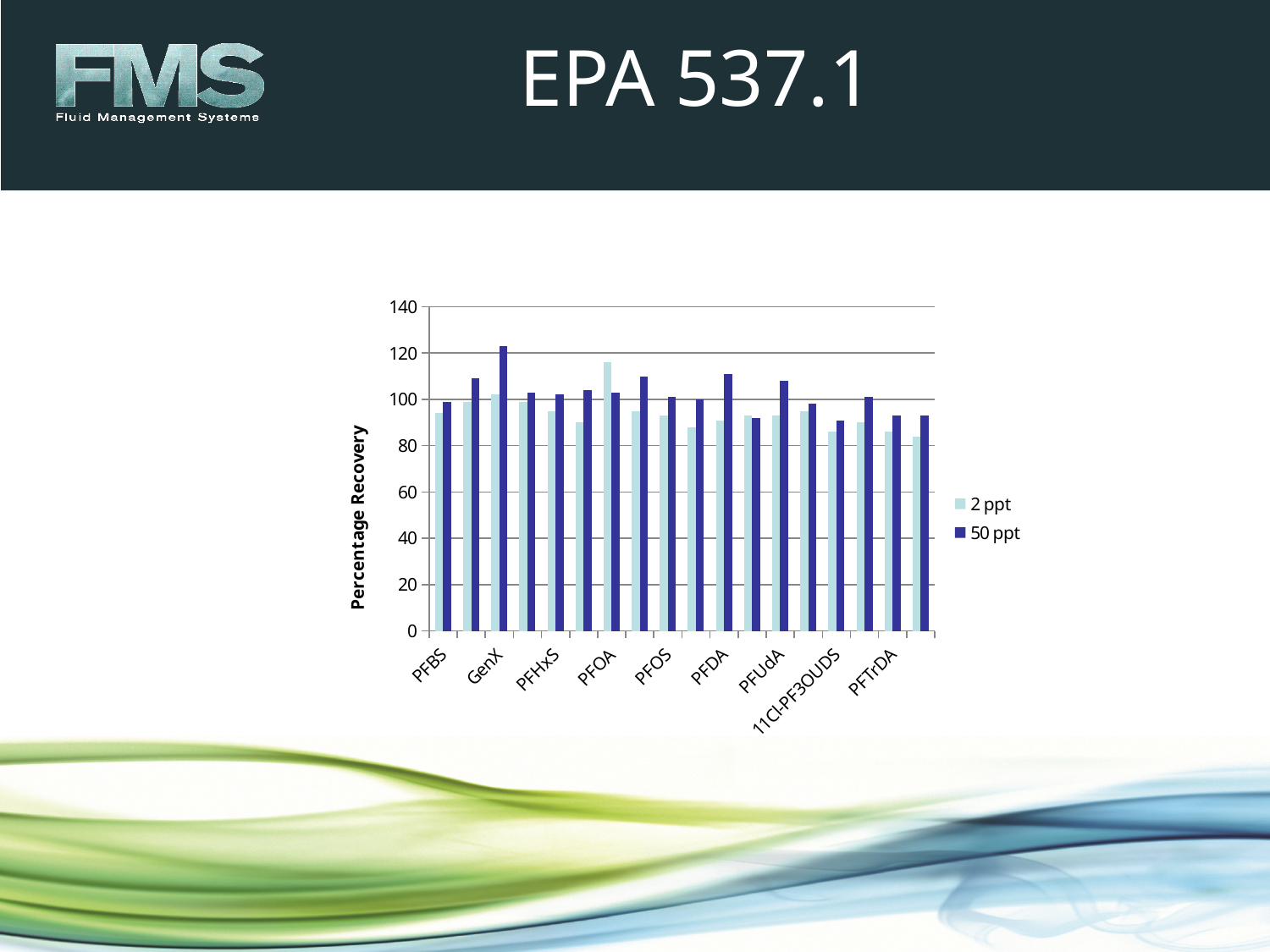
Is the 2 ppt value for PFOA greater or less than 100? greater Which category has the highest 2 ppt bar? PFOA How many series does the legend list? 2 Is the 50 ppt value for PFDA greater or less than 100? greater Is the 50 ppt value for GenX greater or less than 120? greater What is the label on the vertical axis? Percentage Recovery What kind of chart is shown on the slide? bar chart For PFOA, which series has the larger value, 2 ppt or 50 ppt? 2 ppt Which category has the highest 50 ppt bar? GenX What are the two series named in the legend? 2 ppt and 50 ppt How many category labels are printed along the x axis? 9